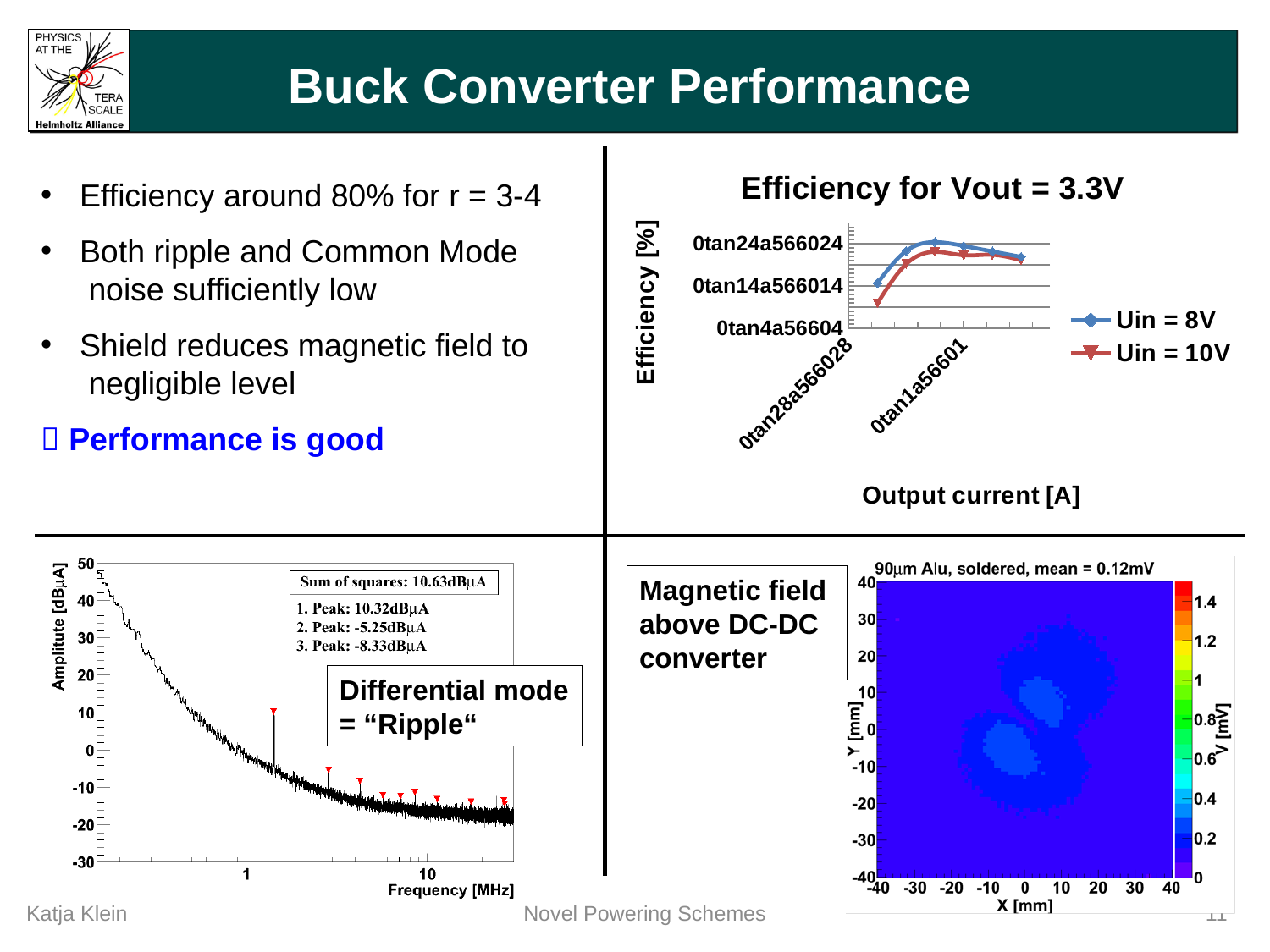
In the 'Efficiency for Vout = 3.3V' chart, what is the label of the x axis? Output current [A] In the 'Efficiency for Vout = 3.3V' chart, what are the two legend entries? Uin = 8V and Uin = 10V What kind of chart is the 'Efficiency for Vout = 3.3V' chart? line chart In the 'Efficiency for Vout = 3.3V' chart, how many series does the legend list? 2 In the bottom-right magnetic field map, what is the maximum value shown on the colour scale? 1.4 In the bottom-left amplitude vs frequency chart, what is the printed 'Sum of squares' value? 10.63dBμA In the 'Efficiency for Vout = 3.3V' chart, which series has the higher efficiency values, Uin = 8V or Uin = 10V? Uin = 8V In the bottom-left amplitude vs frequency chart, does the amplitude rise or fall as frequency increases? fall In the bottom-right magnetic field map, what mean value is printed in its title? 0.12mV What is the title of the chart in the top right of the slide? Efficiency for Vout = 3.3V In the 'Efficiency for Vout = 3.3V' chart, does the Uin = 10V series rise or fall at the start of the x axis? rise In the bottom-left amplitude vs frequency chart, what is the value printed for the 1st peak? 10.32dBμA